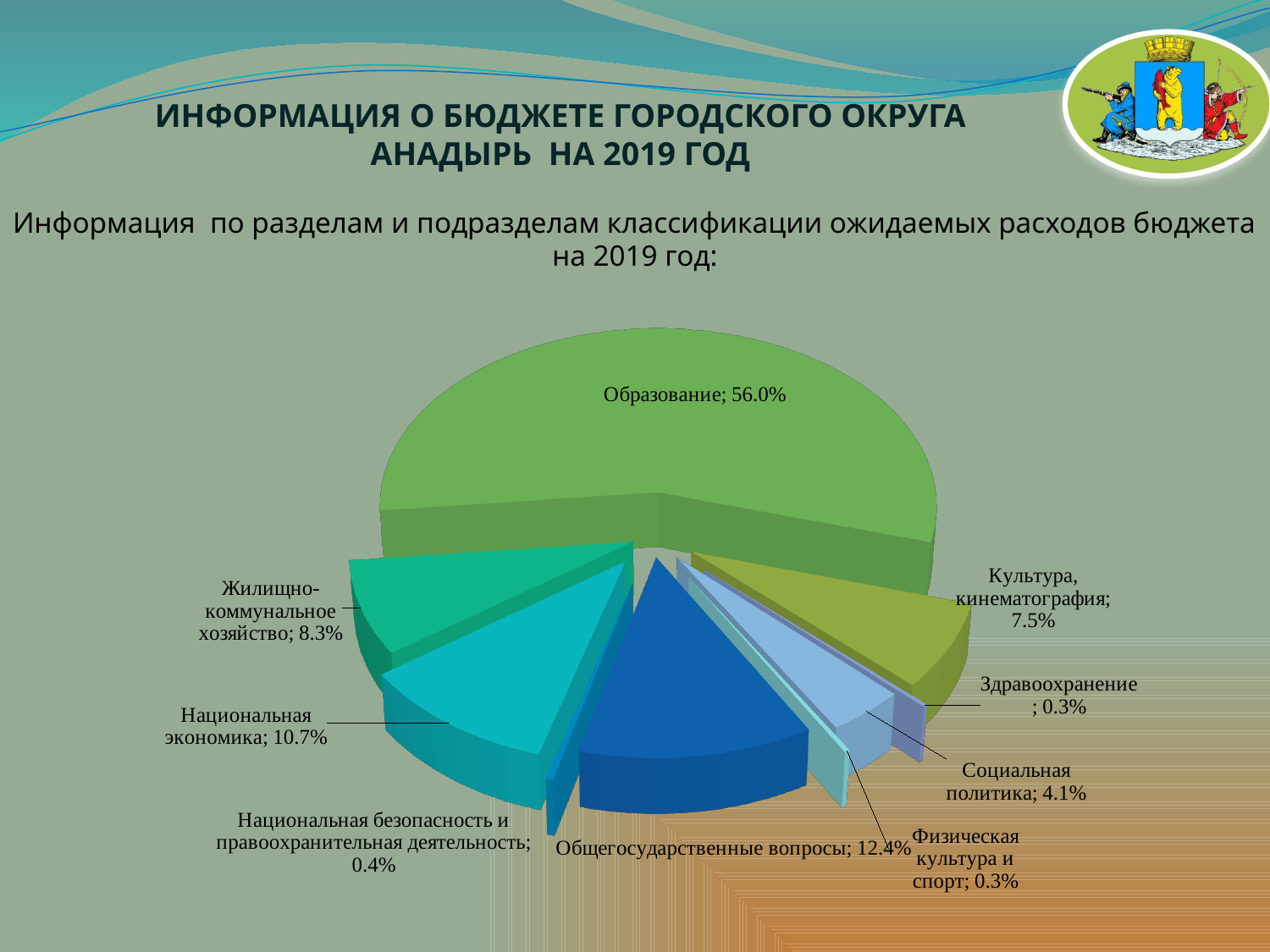
What is the combined share of Здравоохранение and Физическая культура и спорт? 0.6% Which is larger: the share for Культура, кинематография or the share for Жилищно-коммунальное хозяйство? Жилищно-коммунальное хозяйство What share of expected 2019 budget expenditures goes to Образование? 56.0% What share is shown for Социальная политика? 4.1% What is the difference between the shares of Общегосударственные вопросы and Национальная экономика? 1.7% What percentage is labelled for Жилищно-коммунальное хозяйство? 8.3% What type of chart is used on the slide? Pie chart What is the share for Национальная экономика? 10.7% What percentage is shown for Общегосударственные вопросы? 12.4% How many sections are shown in the pie chart? 9 What percentage is shown for Национальная безопасность и правоохранительная деятельность? 0.4% Which section has the largest share of the budget expenditures? Образование